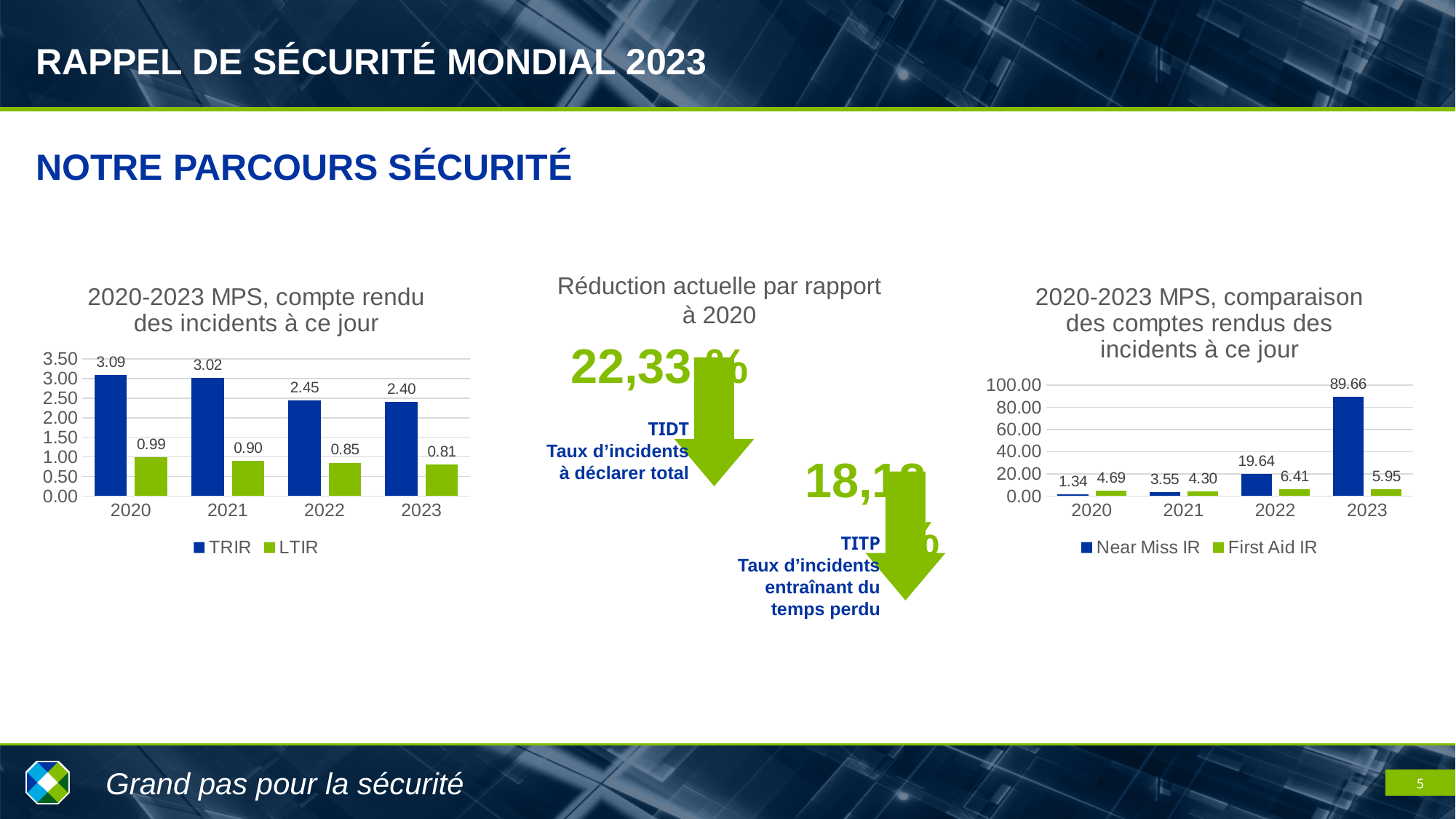
In the chart titled '2020-2023 MPS, comparaison des comptes rendus des incidents à ce jour', what is the First Aid IR value for 2021? 4.30 What kind of chart is the one titled '2020-2023 MPS, comparaison des comptes rendus des incidents à ce jour'? bar chart In the chart titled '2020-2023 MPS, compte rendu des incidents à ce jour', what is the LTIR value for 2023? 0.81 In the chart titled '2020-2023 MPS, compte rendu des incidents à ce jour', what is the TRIR value for 2020? 3.09 In the chart titled '2020-2023 MPS, comparaison des comptes rendus des incidents à ce jour', which is larger in 2020: Near Miss IR or First Aid IR? First Aid IR In the chart titled '2020-2023 MPS, compte rendu des incidents à ce jour', how many series does the legend list? 2 In the chart titled '2020-2023 MPS, compte rendu des incidents à ce jour', which year has the lowest TRIR value? 2023 In the chart titled '2020-2023 MPS, comparaison des comptes rendus des incidents à ce jour', how many years are shown on the x axis? 4 In the chart titled '2020-2023 MPS, compte rendu des incidents à ce jour', does the TRIR value rise or fall from 2020 to 2023? fall In the chart titled '2020-2023 MPS, comparaison des comptes rendus des incidents à ce jour', which year has the highest Near Miss IR value? 2023 In the chart titled '2020-2023 MPS, comparaison des comptes rendus des incidents à ce jour', what is the Near Miss IR value for 2023? 89.66 In the chart titled '2020-2023 MPS, compte rendu des incidents à ce jour', what is the difference between the TRIR values for 2020 and 2023? 0.69